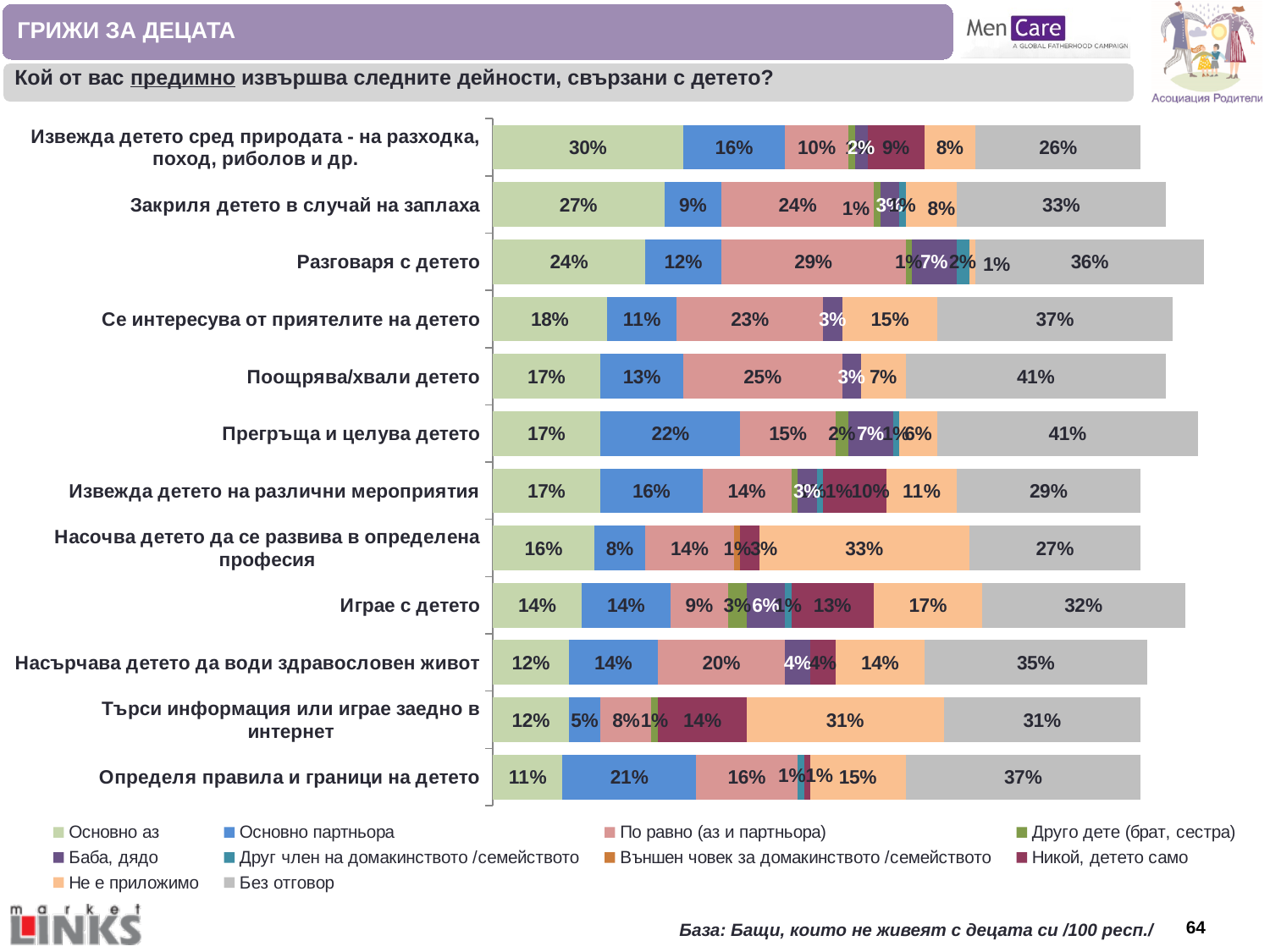
For "Определя правила и граници на детето", what is the difference between "Основно партньора" and "Основно аз"? 10 percentage points Is the "Без отговор" value larger for "Разговаря с детето" or for "Извежда детето сред природата - на разходка, поход, риболов и др."? Разговаря с детето What is the value of "Основно аз" for "Извежда детето сред природата - на разходка, поход, риболов и др."? 30% What is the value of "Не е приложимо" for "Насочва детето да се развива в определена професия"? 33% How many series does the legend list? 10 How many activities (categories) are shown in the chart? 12 What type of chart is shown on the slide? Stacked bar chart What is the value of "Без отговор" for "Поощрява/хвали детето"? 41% Which activity has the highest value for "Основно аз"? Извежда детето сред природата - на разходка, поход, риболов и др. Which activity has the highest value for "Основно партньора"? Прегръща и целува детето What is the value of "По равно (аз и партньора)" for "Разговаря с детето"? 29% Which activity has the lowest value for "Основно аз"? Определя правила и граници на детето